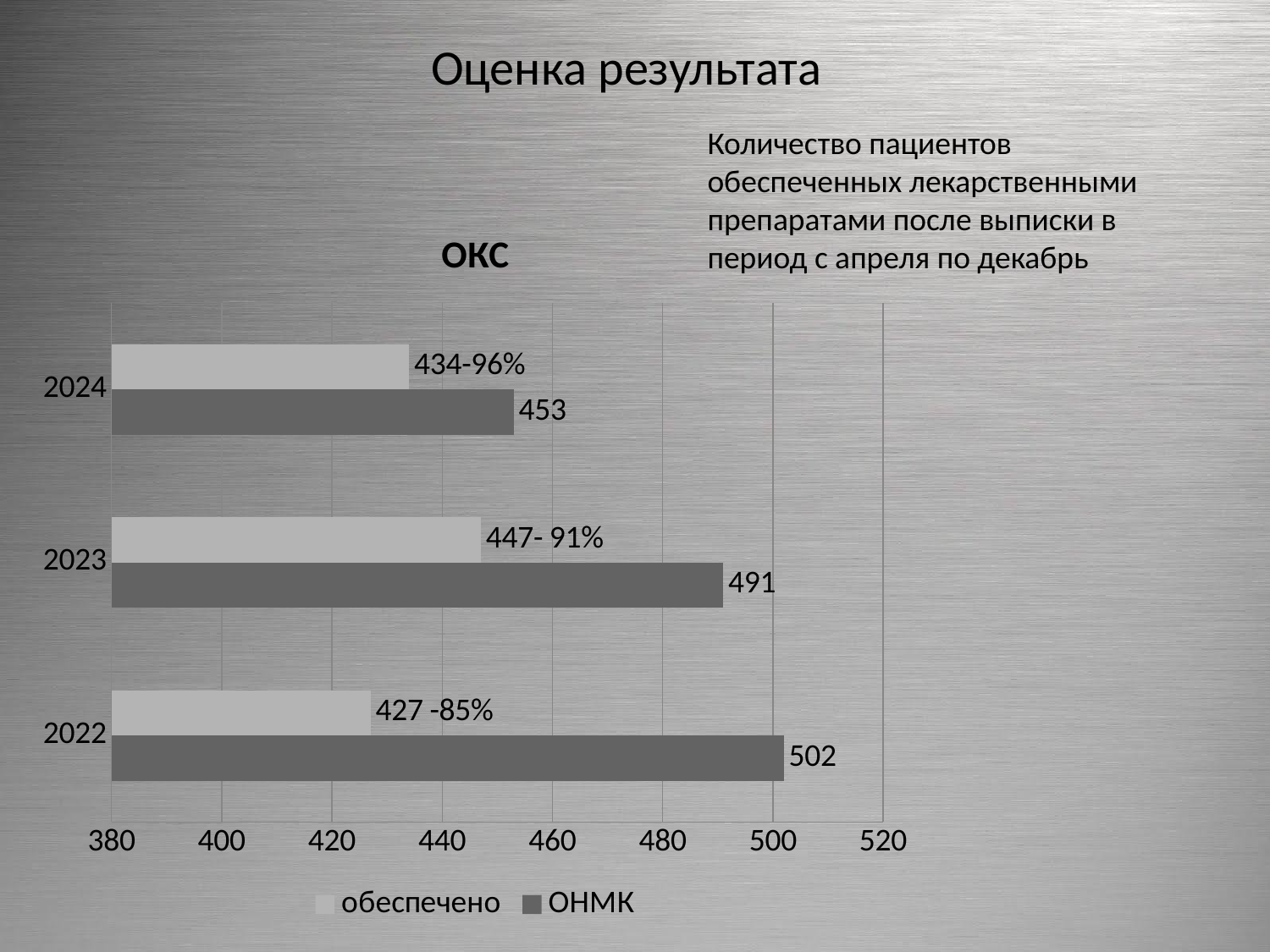
What is the ОНМК value for 2022? 502 Which year has the lowest ОНМК value? 2024 Which is larger in 2023: the ОНМК value or the обеспечено value? ОНМК How many years (categories) are shown on the chart? 3 What is the title of the chart? ОКС Do the ОНМК values rise or fall from 2022 to 2024? fall Which year has the highest ОНМК value? 2022 How many series does the legend list? 2 What is the difference between the ОНМК value and the обеспечено value in 2022? 75 What is the ОНМК value for 2024? 453 What type of chart is shown on the slide? bar chart What data label is shown for обеспечено in 2023? 447- 91%